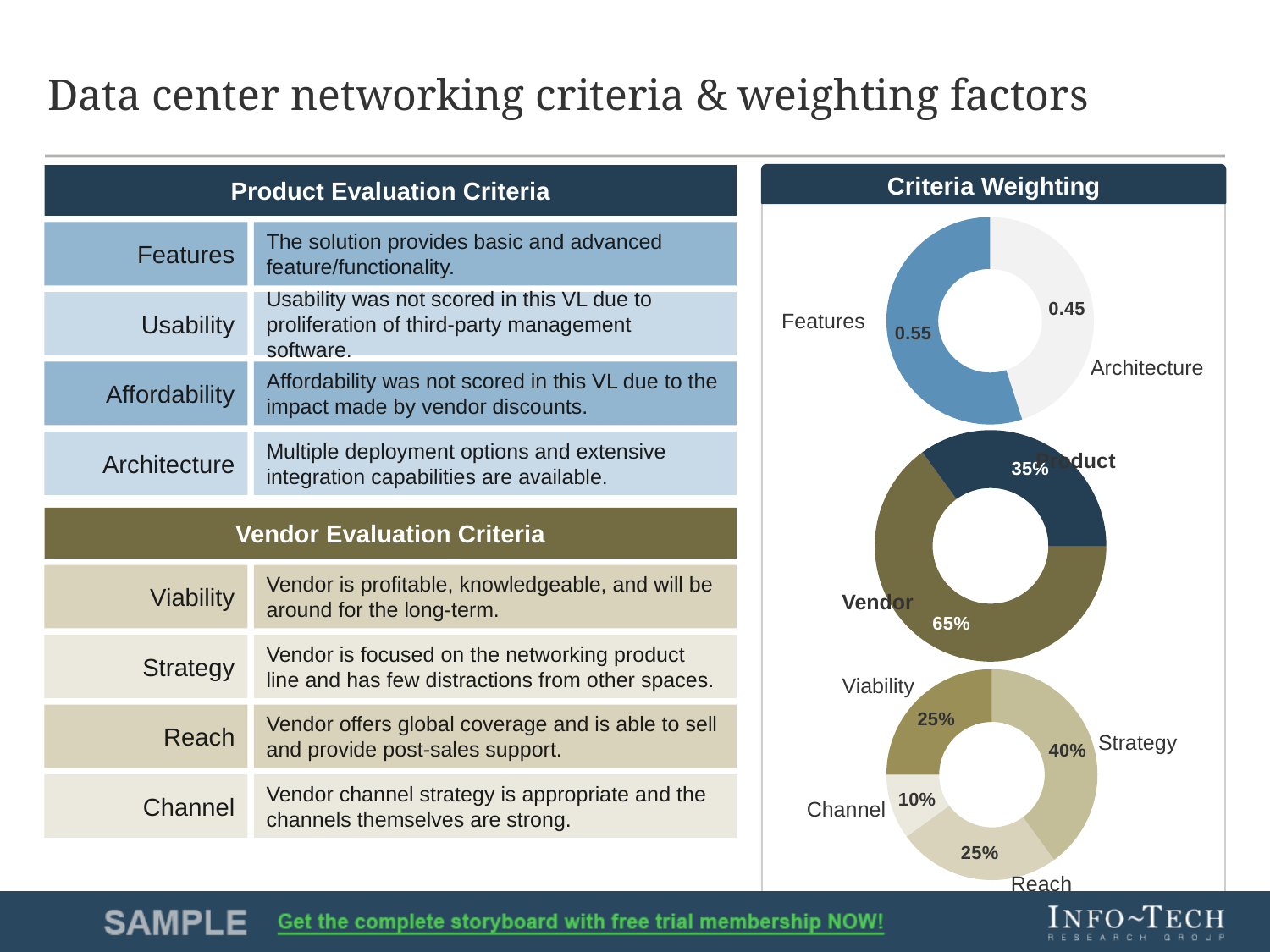
In the bottom donut chart under Criteria Weighting, what is the value for Strategy? 40% In the top donut chart under Criteria Weighting, which category has the larger value, Features or Architecture? Features In the bottom donut chart under Criteria Weighting, which category has the highest value? Strategy How many categories are shown in the bottom donut chart under Criteria Weighting? 4 In the top donut chart under Criteria Weighting, what is the value for Features? 0.55 In the top donut chart under Criteria Weighting, what is the value for Architecture? 0.45 In the bottom donut chart under Criteria Weighting, what is the value for Channel? 10% What type of chart is used in the Criteria Weighting section? Donut chart In the middle donut chart under Criteria Weighting, what is the value for Product? 35% In the middle donut chart under Criteria Weighting, what is the value for Vendor? 65% In the middle donut chart under Criteria Weighting, what is the difference between the Vendor and Product values? 30% In the bottom donut chart under Criteria Weighting, which category has the lowest value? Channel